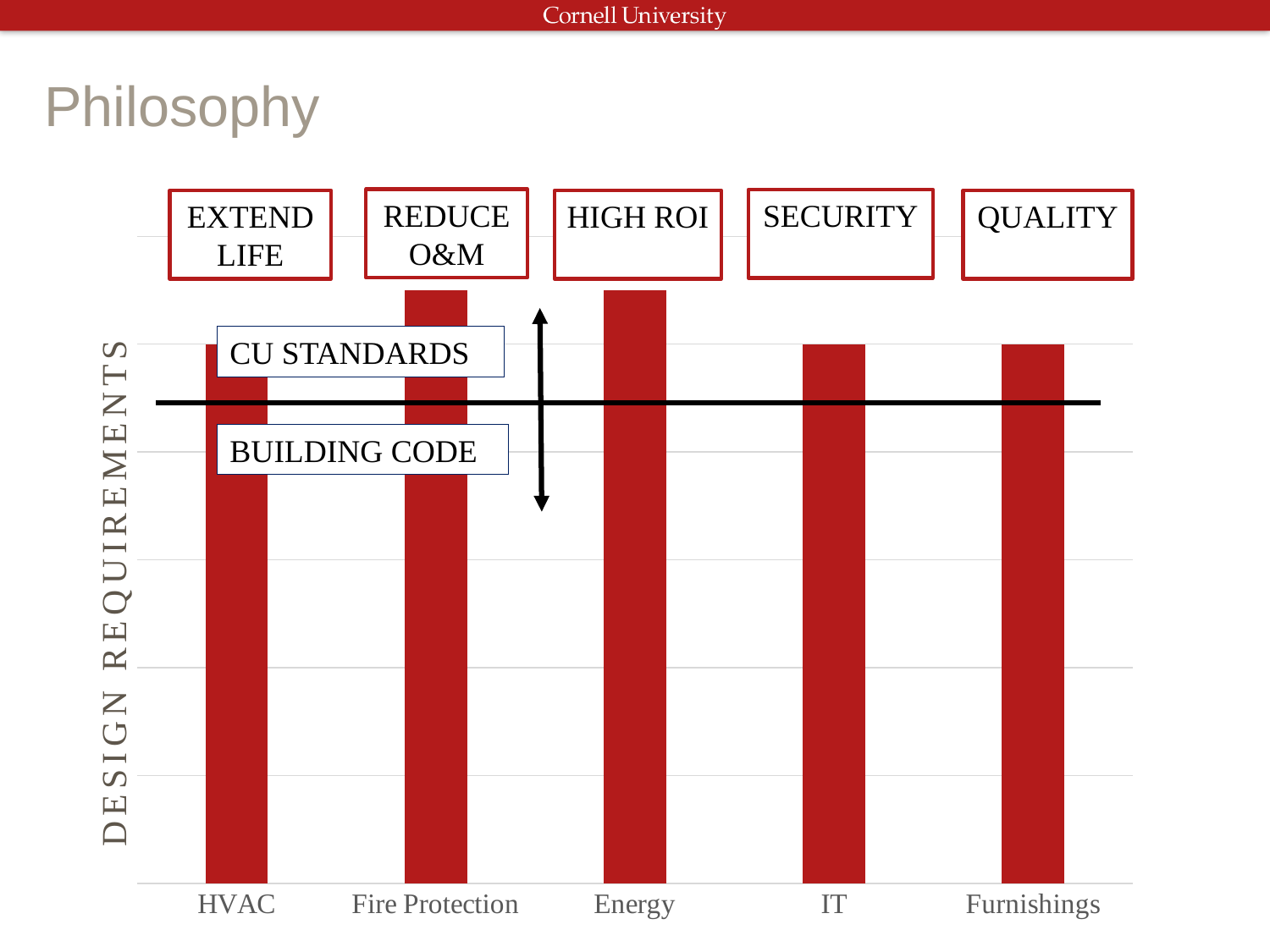
Which is larger in the chart, the bar for Energy or the bar for Furnishings? Energy Which is larger in the chart, the bar for Furnishings or the bar for Fire Protection? Fire Protection What is the label of the first category on the x axis of the chart? HVAC Which is larger in the chart, the bar for Energy or the bar for IT? Energy What kind of chart is shown on the slide? bar chart What is the title of the vertical axis of the chart? DESIGN REQUIREMENTS How many categories are plotted along the x axis of the chart? 5